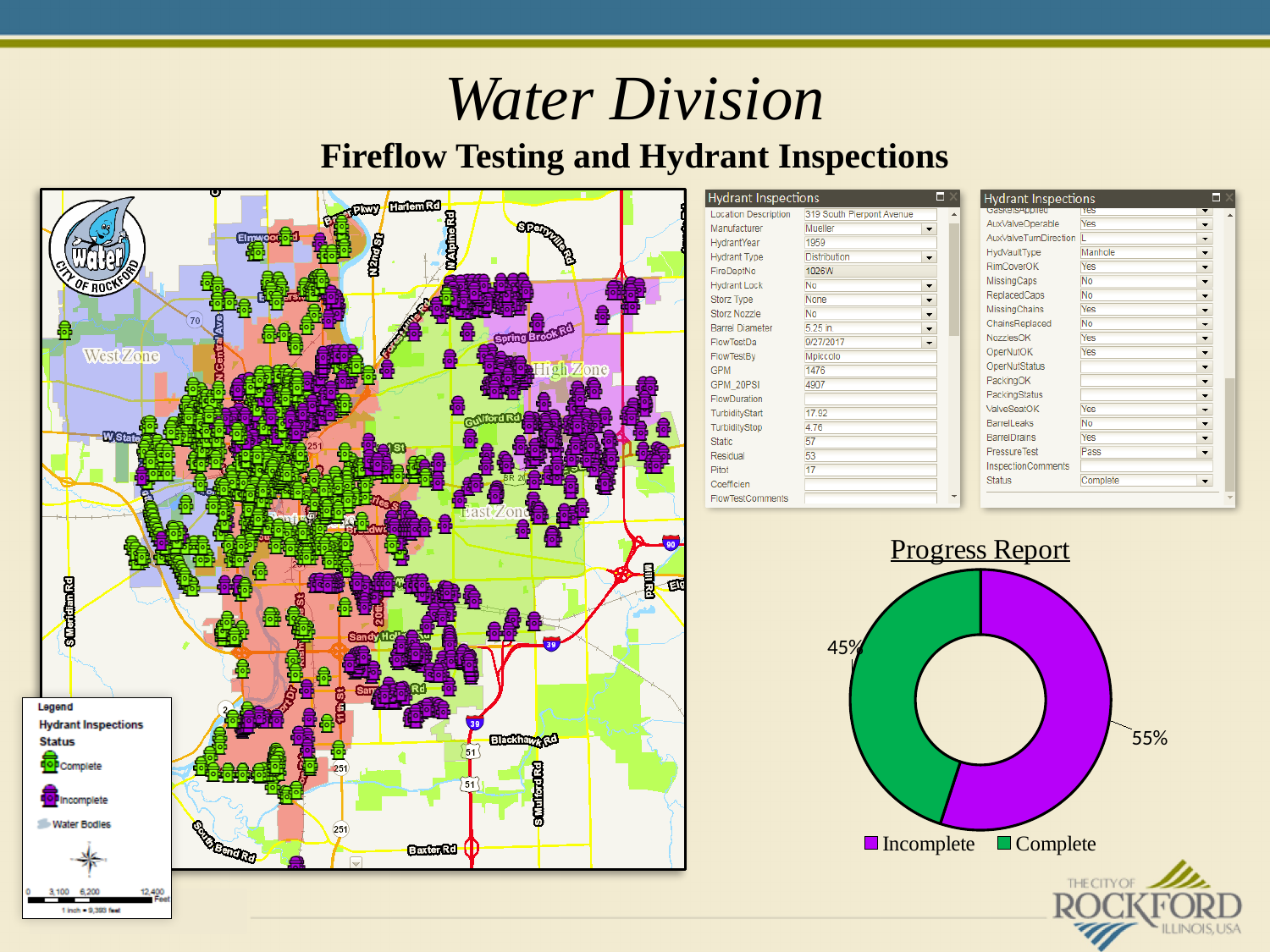
In the Progress Report chart, what percentage is shown for Incomplete? 55% How many entries does the legend of the Progress Report chart list? 2 What is the title of the chart on the right side of the slide? Progress Report In the Progress Report chart, what is the difference between the Incomplete and Complete percentages? 10% What share of the Progress Report chart does the Complete slice represent? 45% How many slices does the Progress Report chart have? 2 In the Progress Report chart, what colour represents Incomplete? purple In the Progress Report chart, which is larger, Incomplete or Complete? Incomplete In the Progress Report chart, which category has the largest slice? Incomplete In the Progress Report chart, what percentage is shown for Complete? 45% In the Progress Report chart, which category has the smallest slice? Complete What kind of chart is the Progress Report chart? doughnut chart